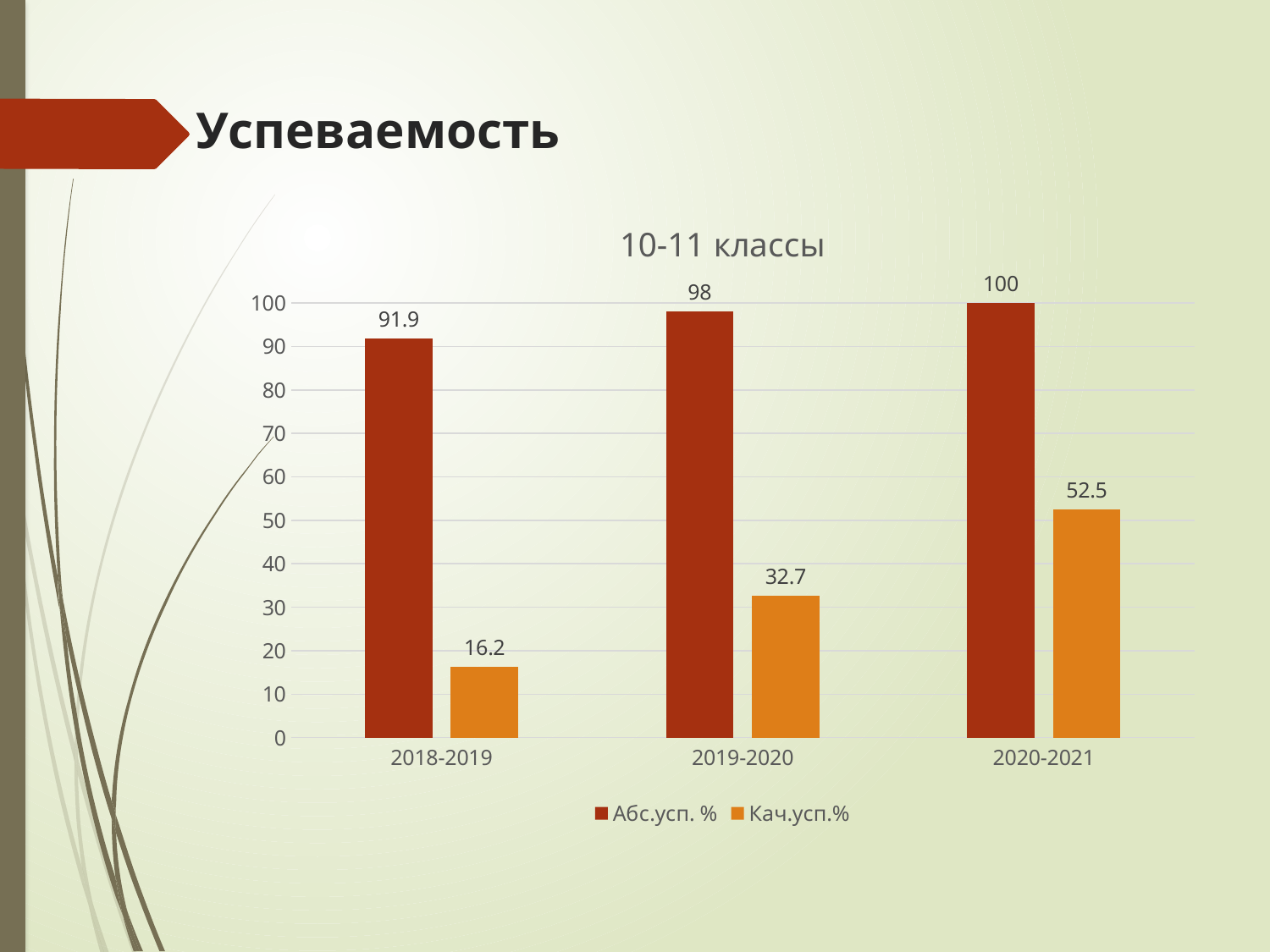
By how much did Кач.усп.% increase from 2019-2020 to 2020-2021? 19.8 What is the difference between Абс.усп. % and Кач.усп.% in 2018-2019? 75.7 Which year has the highest Кач.усп.% value? 2020-2021 How many series does the legend list? 2 What is the value of Кач.усп.% for 2020-2021? 52.5 What is the value of Абс.усп. % for 2018-2019? 91.9 Which year has the lowest Абс.усп. % value? 2018-2019 What is the value of Кач.усп.% for 2019-2020? 32.7 Which is larger: Кач.усп.% in 2018-2019 or Кач.усп.% in 2019-2020? 2019-2020 What kind of chart is shown on the slide? Bar chart How many year categories are shown on the x axis? 3 Does Кач.усп.% rise or fall from 2018-2019 to 2020-2021? Rise